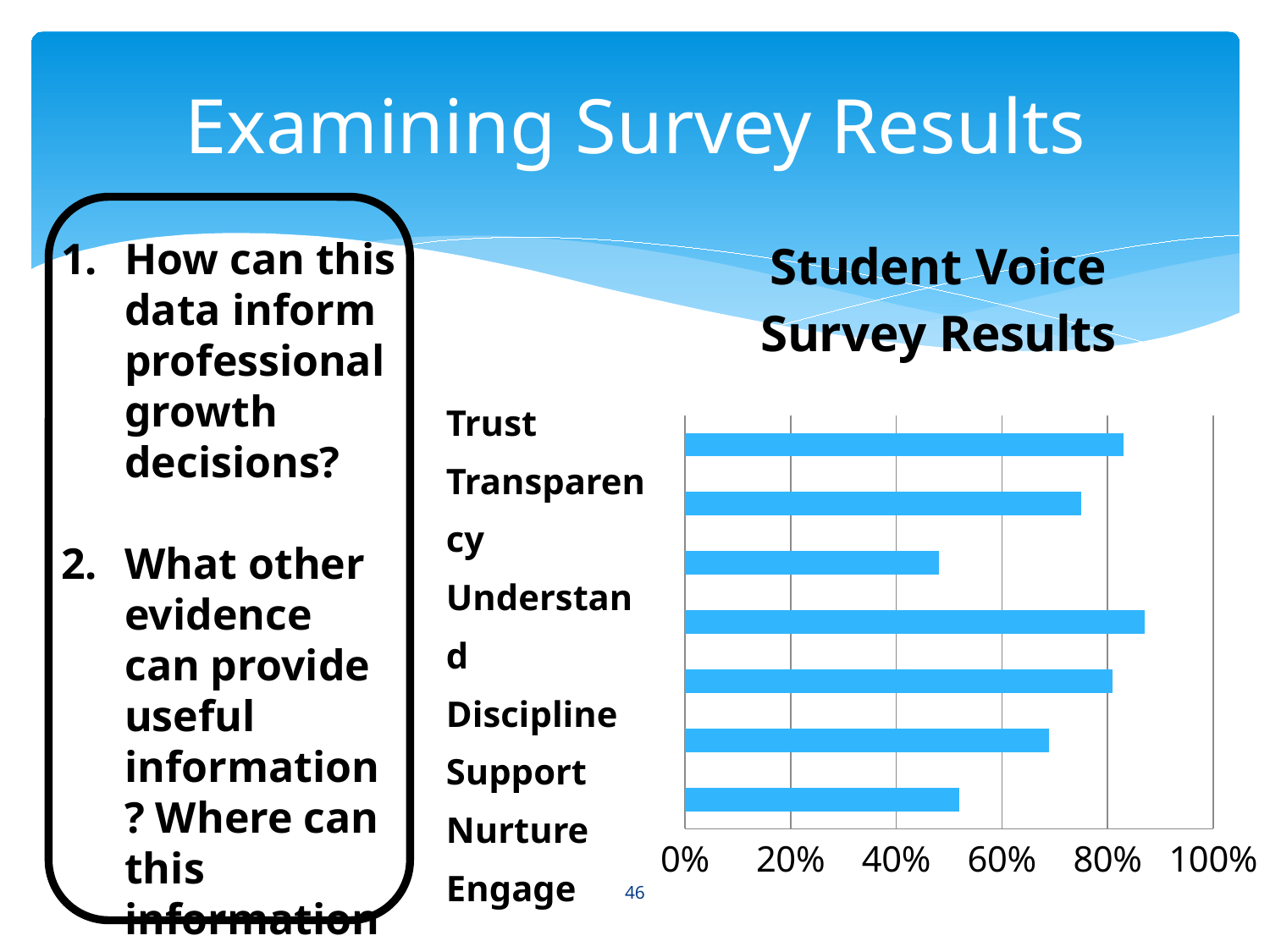
Is the value for Engage greater or less than 40%? greater Is the value for Discipline greater or less than 80%? greater What kind of chart is shown on the slide? bar chart Which is larger, the value for Trust or the value for Nurture? Trust Which is larger, the value for Discipline or the value for Understand? Discipline How many categories (bars) does the Student Voice Survey Results chart show? 7 Is the value for Understand greater or less than 60%? less What is the title of the chart? Student Voice Survey Results What is the highest value shown on the horizontal axis of the chart? 100% Which category has the longest bar in the Student Voice Survey Results chart? Discipline